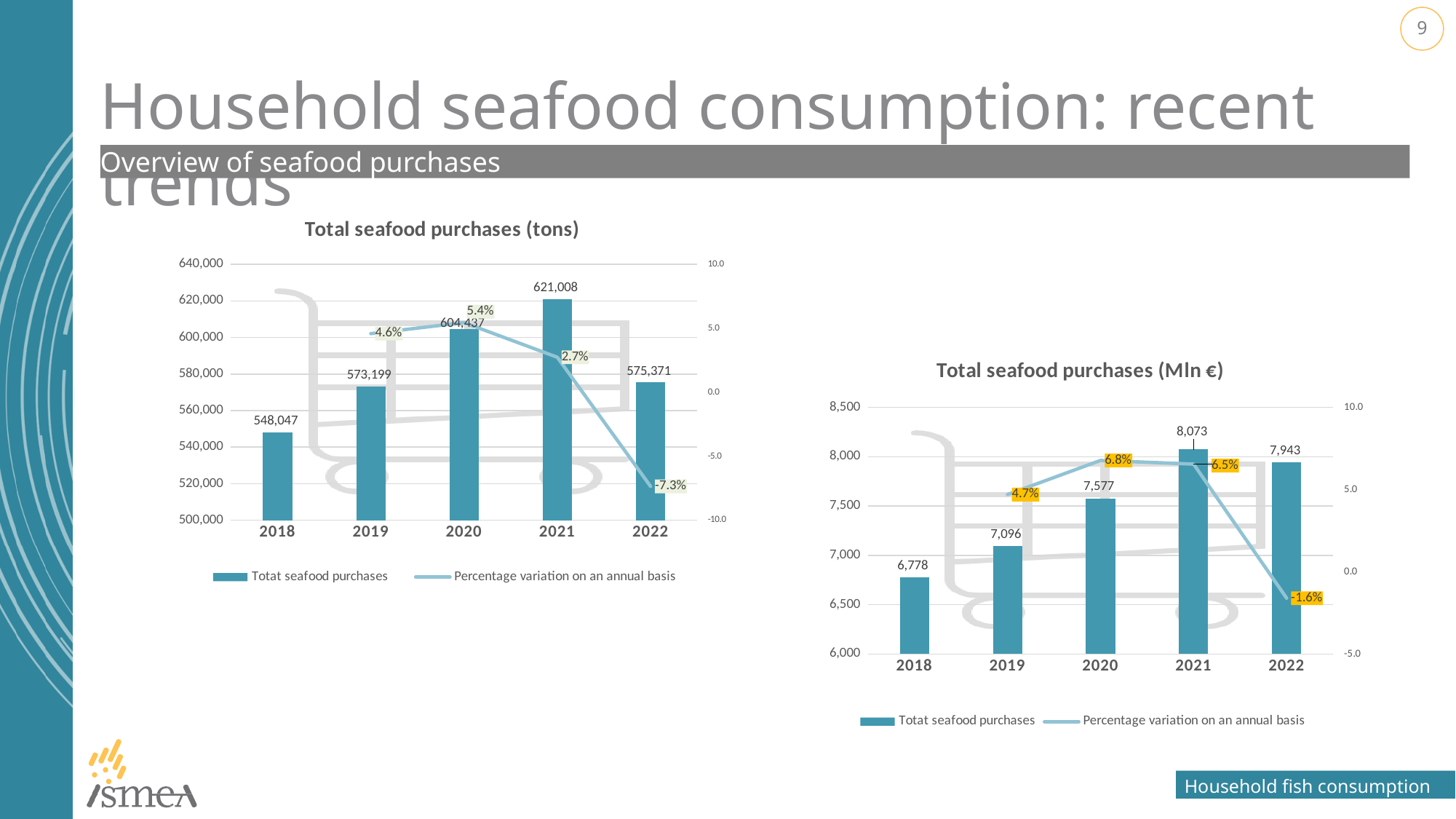
In the 'Total seafood purchases (Mln €)' chart, is the value for 2019 larger or smaller than the value for 2022? smaller In the 'Total seafood purchases (tons)' chart, what is the percentage variation shown for 2022? -7.3% In the 'Total seafood purchases (tons)' chart, how many series does the legend list? 2 In the 'Total seafood purchases (tons)' chart, what is the difference between the 2021 and 2022 values? 45,637 In the 'Total seafood purchases (Mln €)' chart, what is the difference between the 2019 and 2018 values? 318 In the 'Total seafood purchases (tons)' chart, which year has the lowest total seafood purchases? 2018 In the 'Total seafood purchases (Mln €)' chart, what is the value for 2020? 7,577 In the 'Total seafood purchases (Mln €)' chart, which year has the highest total seafood purchases? 2021 In the 'Total seafood purchases (tons)' chart, do the bar values rise or fall from 2018 to 2021? rise In the 'Total seafood purchases (Mln €)' chart, what is the percentage variation shown for 2019? 4.7% How many years are shown on the x axis of the 'Total seafood purchases (Mln €)' chart? 5 In the 'Total seafood purchases (tons)' chart, what is the value for 2021? 621,008